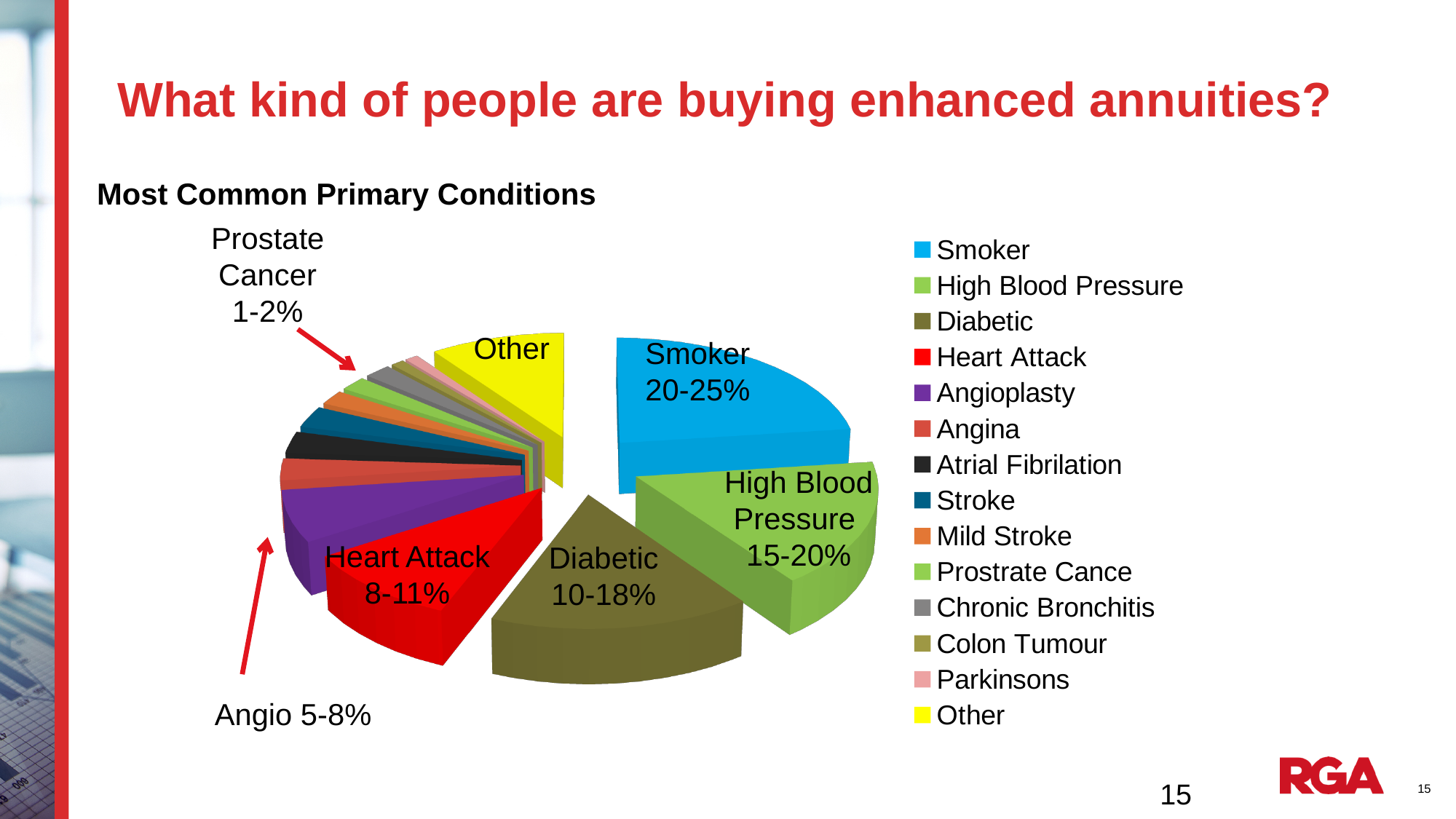
What share is shown for High Blood Pressure? 15-20% What share is shown for the Smoker slice? 20-25% What colour is the Smoker slice? Blue What share is shown for Prostate Cancer? 1-2% What share is shown for the Diabetic slice? 10-18% Which condition has the largest slice of the pie? Smoker What share is shown for Heart Attack? 8-11% What is the title of the chart? Most Common Primary Conditions Which slice is larger, Heart Attack or High Blood Pressure? High Blood Pressure What share is shown for Angio (Angioplasty)? 5-8% How many categories does the legend list? 14 What kind of chart is shown on the slide? Pie chart